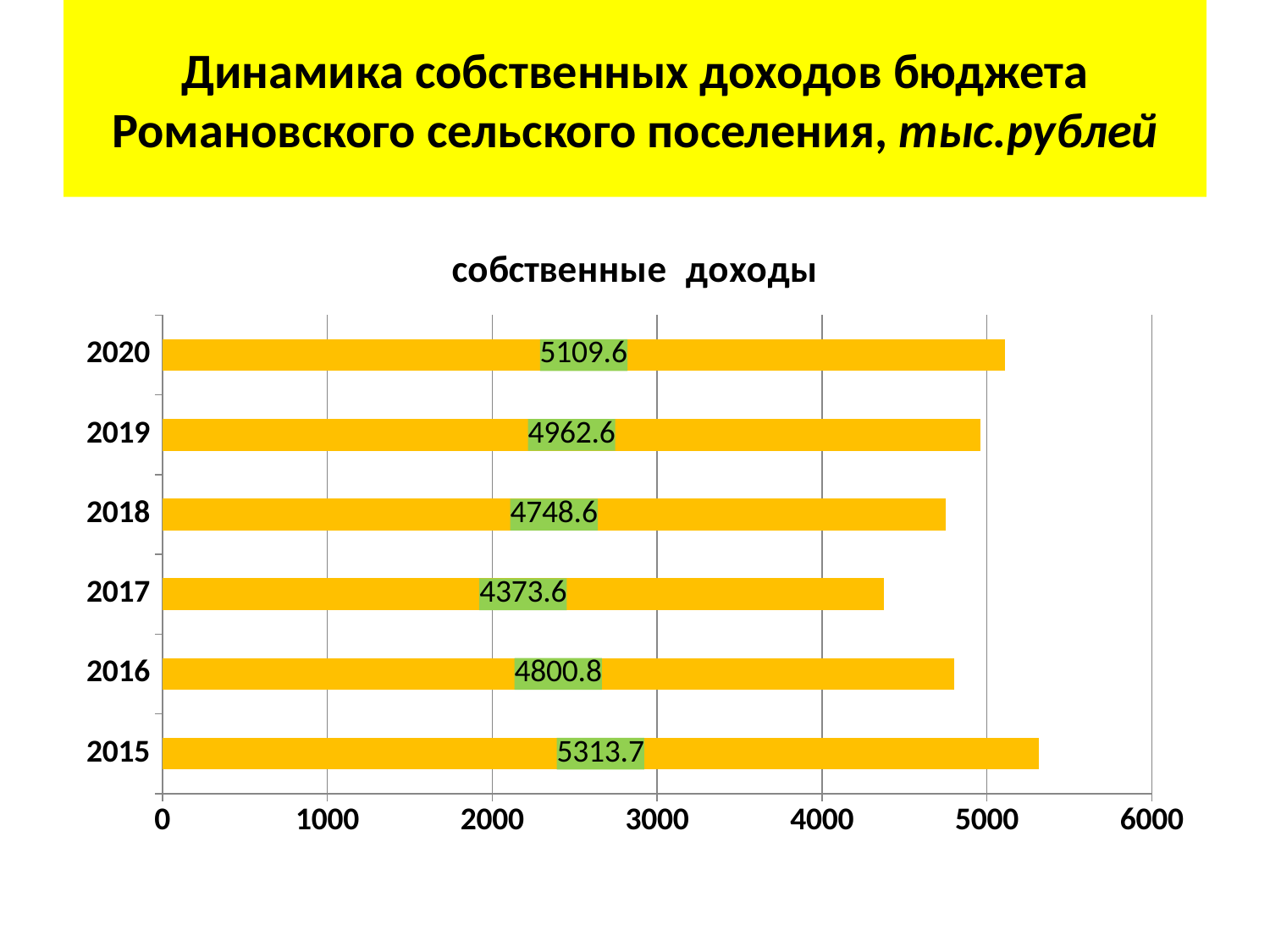
Which is larger, the value for 2016 or the value for 2018? 2016 How many years are shown in the chart? 6 What kind of chart is shown on the slide? bar chart What is the value for 2015 in the chart? 5313.7 Which year has the highest value in the chart? 2015 What is the difference between the values for 2020 and 2019? 147.0 What is the value for 2020 in the chart? 5109.6 What is the value for 2017 in the chart? 4373.6 Which year has the lowest value in the chart? 2017 What is the difference between the values for 2015 and 2017? 940.1 Is the value for 2019 greater or less than 5000? less What is the title of the chart? собственные доходы